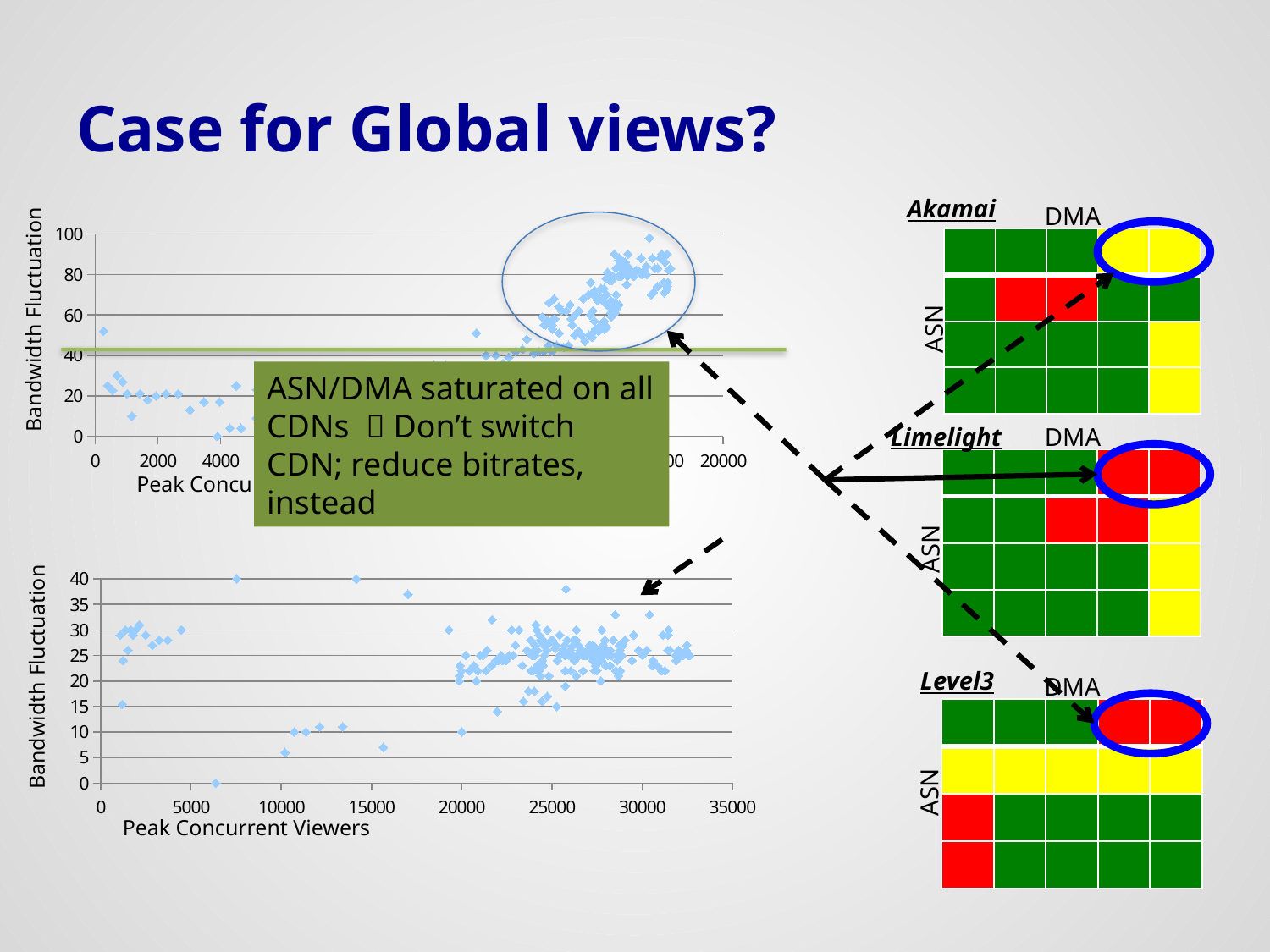
In the top chart, do the bandwidth fluctuation values generally rise or fall as the x-axis value increases? rise What is the highest tick value on the x-axis of the bottom chart? 35000 How many CDN grids (ASN vs DMA) are shown on the right side of the slide? 3 In the top chart, are the bandwidth fluctuation values for the circled cluster of points greater or less than 40? greater In the bottom chart, are the bandwidth fluctuation values for points around 30000 peak concurrent viewers greater or less than 15? greater What is the x-axis label of the bottom chart? Peak Concurrent Viewers What kind of chart is the bottom chart on the left of the slide? scatter chart What is the highest tick value on the y-axis of the bottom chart? 40 What kind of chart is the top chart on the left of the slide? scatter chart In the Akamai grid, what colour are the two circled cells in the top-right corner? yellow What is the highest tick value on the y-axis of the top chart? 100